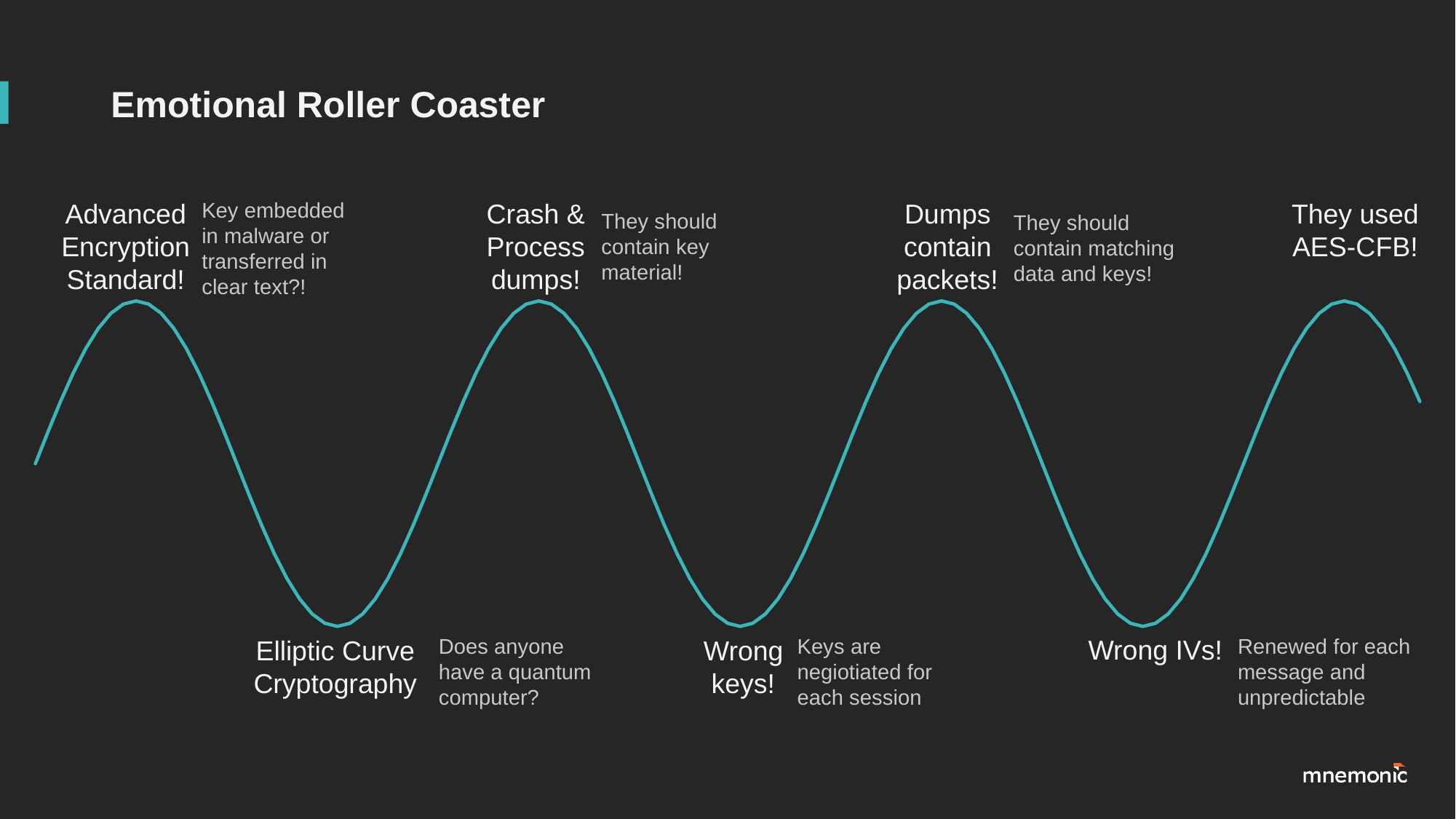
How many troughs (low points) does the line have? 3 Does the line rise or fall immediately after the point labeled 'Dumps contain packets!'? fall Is the point labeled 'Wrong keys!' at a high point or a low point of the line? low point How many peaks (high points) does the line have? 4 What is the title of the slide? Emotional Roller Coaster How many labeled points are there along the line in total? 7 Does the line rise or fall immediately after the point labeled 'Elliptic Curve Cryptography'? rise Which labels sit at the low points of the line? Elliptic Curve Cryptography, Wrong keys!, Wrong IVs! What colour is the line on the chart? teal Which labels sit at the high points of the line? Advanced Encryption Standard!, Crash & Process dumps!, Dumps contain packets!, They used AES-CFB! What kind of chart is shown on the slide? line chart Is the point labeled 'They used AES-CFB!' at a high point or a low point of the line? high point